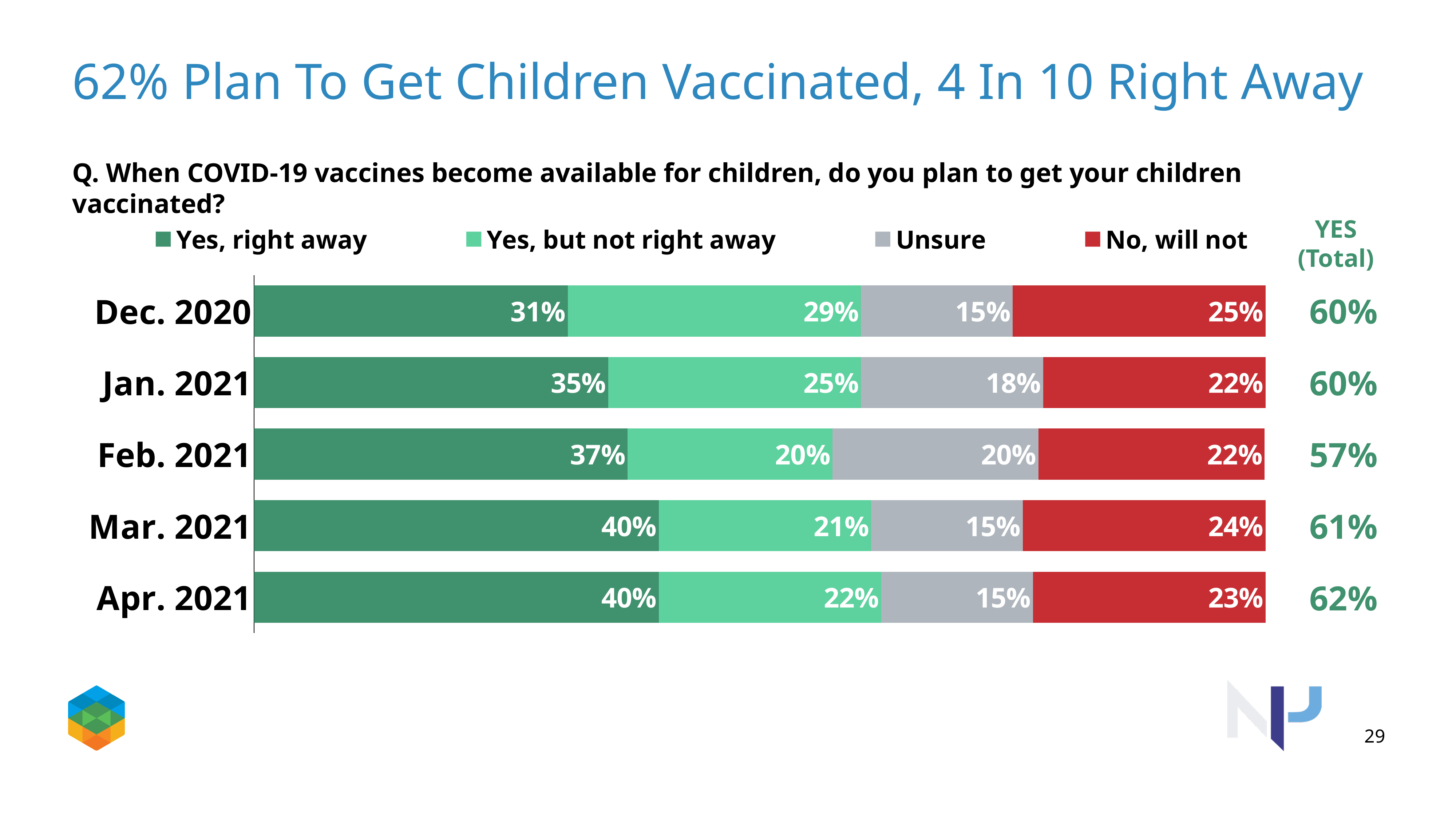
What is the YES (Total) value shown for Apr. 2021? 62% What kind of chart is shown on the slide? Stacked bar chart What percentage said "No, will not" in Mar. 2021? 24% Which month has the lowest "Yes, right away" percentage? Dec. 2020 Which month has the highest "Yes, but not right away" percentage? Dec. 2020 How many months (categories) are shown in the chart? 5 What percentage were "Unsure" in Feb. 2021? 20% How many series does the legend list? 4 Which is larger: the "Unsure" share in Jan. 2021 or in Mar. 2021? Jan. 2021 What percentage said "Yes, right away" in Dec. 2020? 31% Does the "Yes, right away" percentage rise or fall from Dec. 2020 to Apr. 2021? Rise What is the difference between the "Yes, right away" percentages for Apr. 2021 and Dec. 2020? 9 percentage points